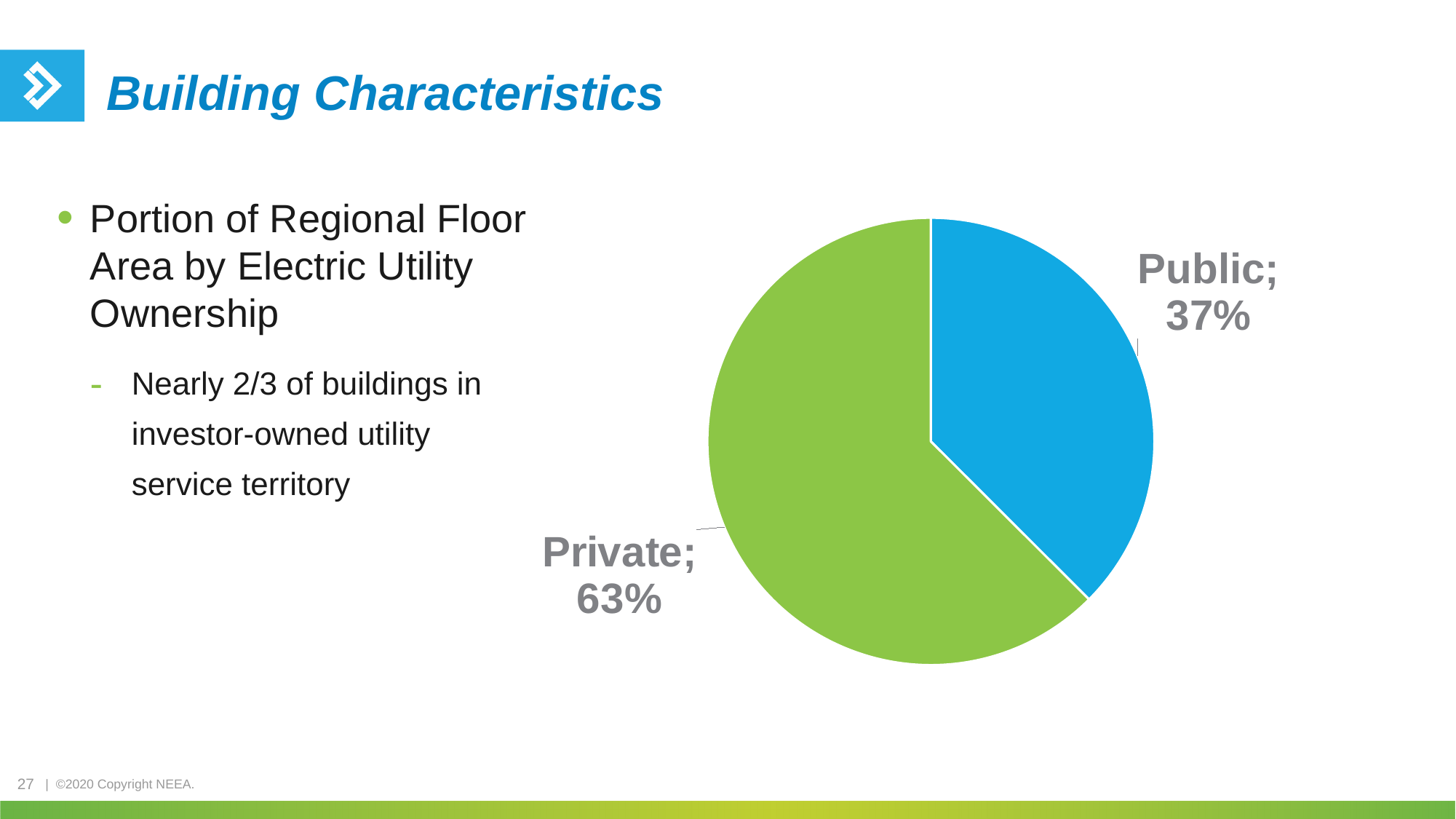
Which is larger, the Public slice or the Private slice? Private What colour is the Public slice of the pie chart? blue What colour is the Private slice of the pie chart? green Is the Private slice greater or less than 50% of the pie? greater What is the difference in percentage points between the Private and Public slices? 26 What share of regional floor area is in Private electric utility ownership? 63% Which slice of the pie chart is the smallest? Public How many slices does the pie chart have? 2 What share of regional floor area is in Public electric utility ownership? 37% Which slice of the pie chart is the largest? Private What kind of chart is shown on the slide? pie chart